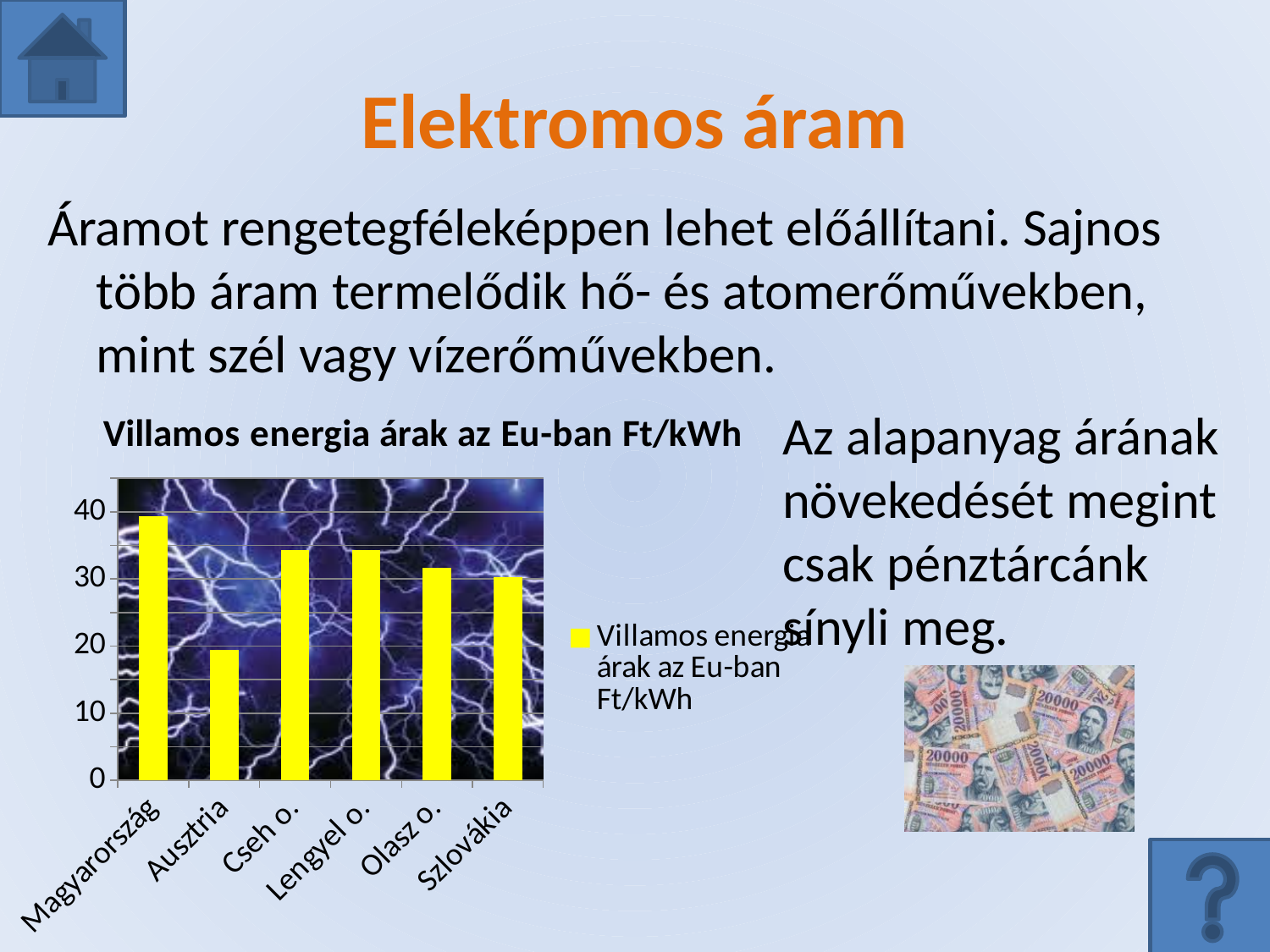
How many series does the chart legend list? 1 What is the title of the chart? Villamos energia árak az Eu-ban Ft/kWh What colour are the bars in the chart? yellow What kind of chart is shown on the slide? bar chart Is the value for Szlovákia greater or less than 40? less Which has a larger value, Cseh o. or Szlovákia? Cseh o. Which country has the lowest electricity price in the chart? Ausztria Which country has the highest electricity price in the chart? Magyarország Is the value for Magyarország greater or less than 30? greater How many countries are shown on the x axis of the chart? 6 Is the value for Olasz o. greater or less than 30? greater